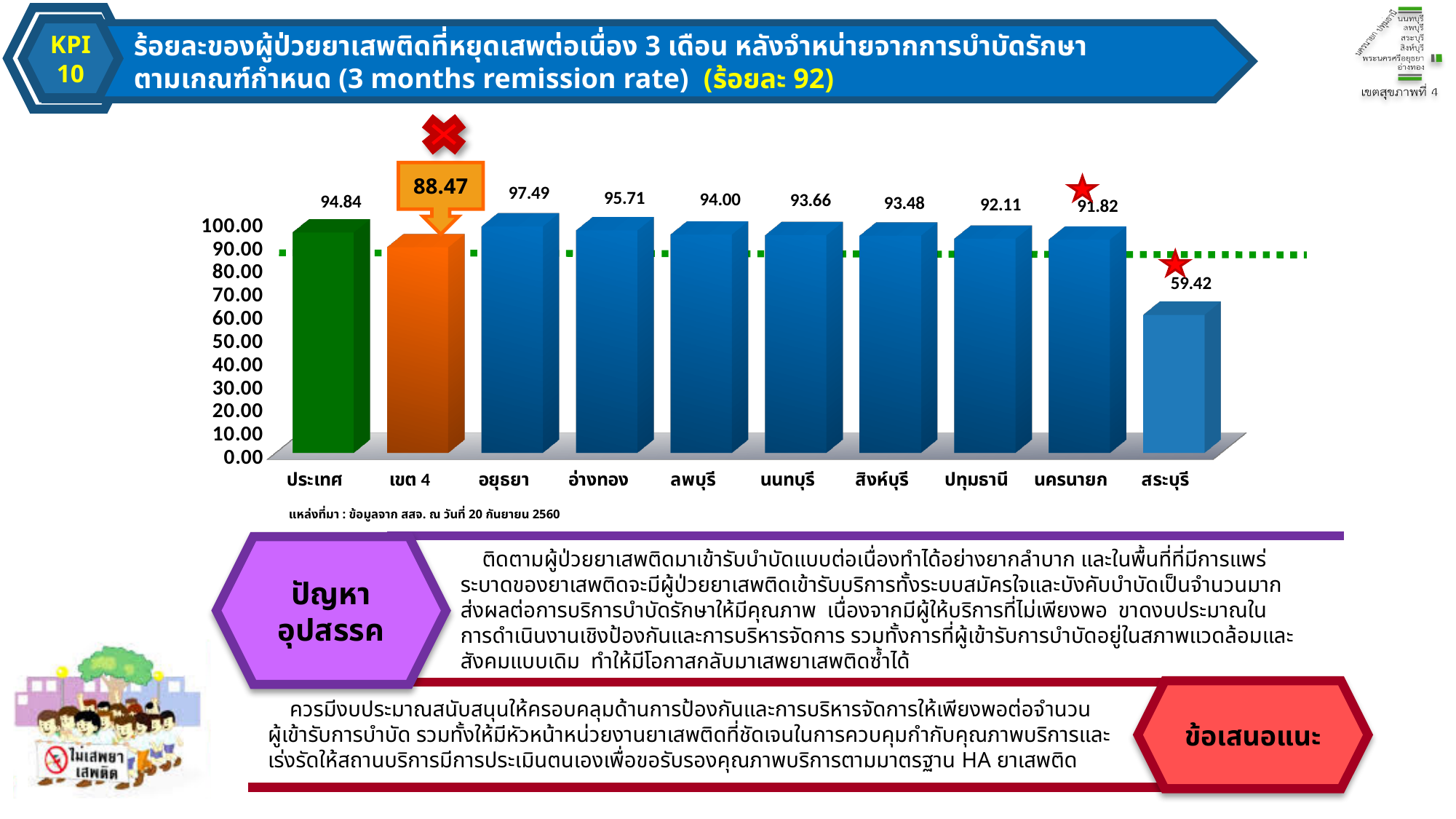
What kind of chart is shown on the slide? bar chart How many categories are shown on the x axis? 10 What is the value for อยุธยา? 97.49 What is the value for เขต 4? 88.47 Which is larger, the value for อ่างทอง or the value for ลพบุรี? อ่างทอง Which category has the highest value? อยุธยา What is the difference between the values for อยุธยา and สระบุรี? 38.07 What is the value for ประเทศ? 94.84 What is the value for สระบุรี? 59.42 What is the difference between the values for ประเทศ and เขต 4? 6.37 Which category has the lowest value? สระบุรี Is the value for สระบุรี greater or less than 60.00? less